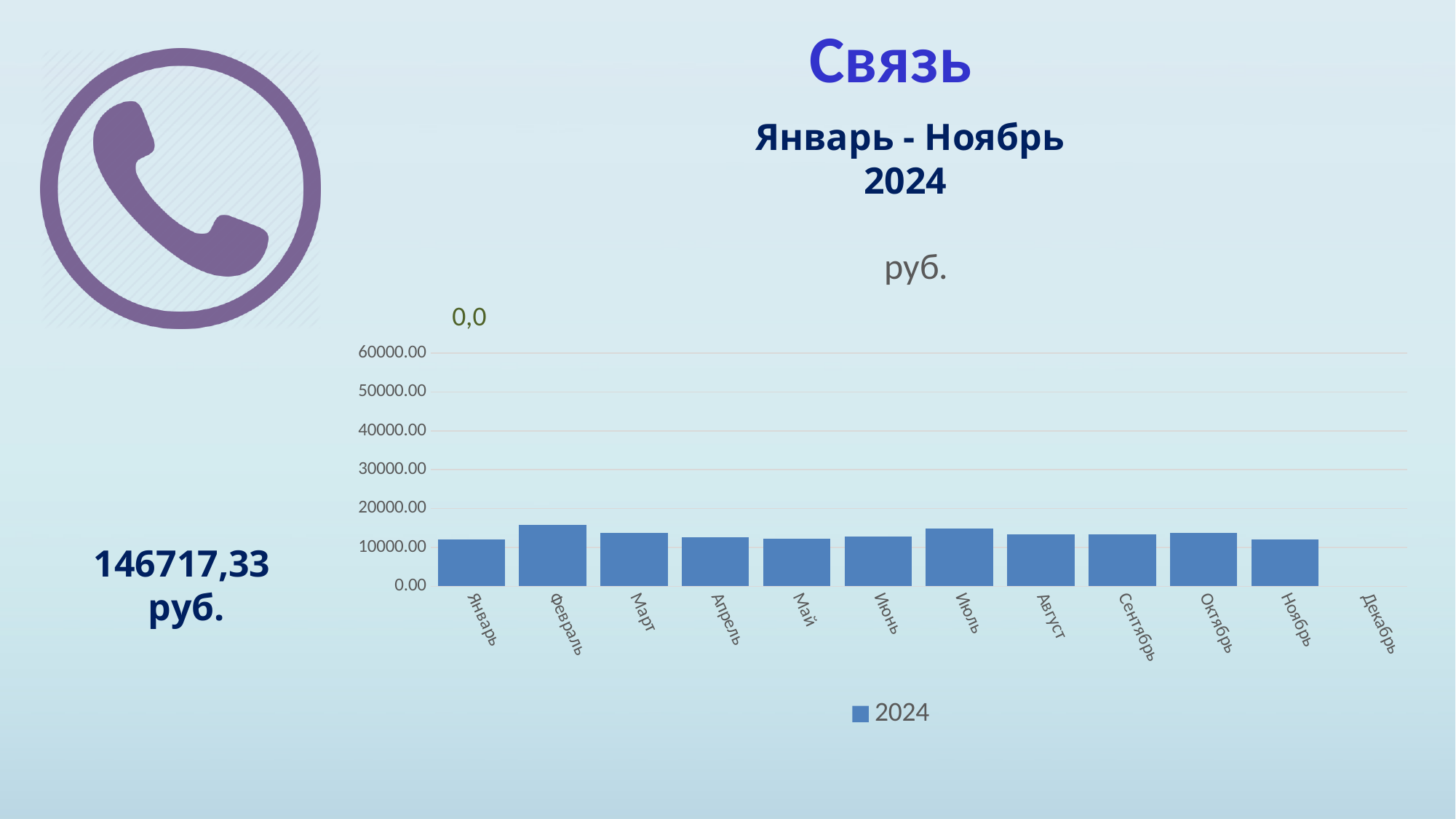
Which is larger, the value for Июль or the value for Май? Июль Is the value for Июль greater or less than 20000.00? less What is the series name shown in the chart legend? 2024 Is the value for Октябрь greater or less than 10000.00? greater Is the value for Январь greater or less than 20000.00? less What kind of chart is shown on the slide? bar chart Which is larger, the value for Февраль or the value for Январь? Февраль How many categories are shown on the x axis of the chart? 12 What is the title of the chart? руб. How many series does the chart legend list? 1 Which month on the x axis has no bar plotted? Декабрь